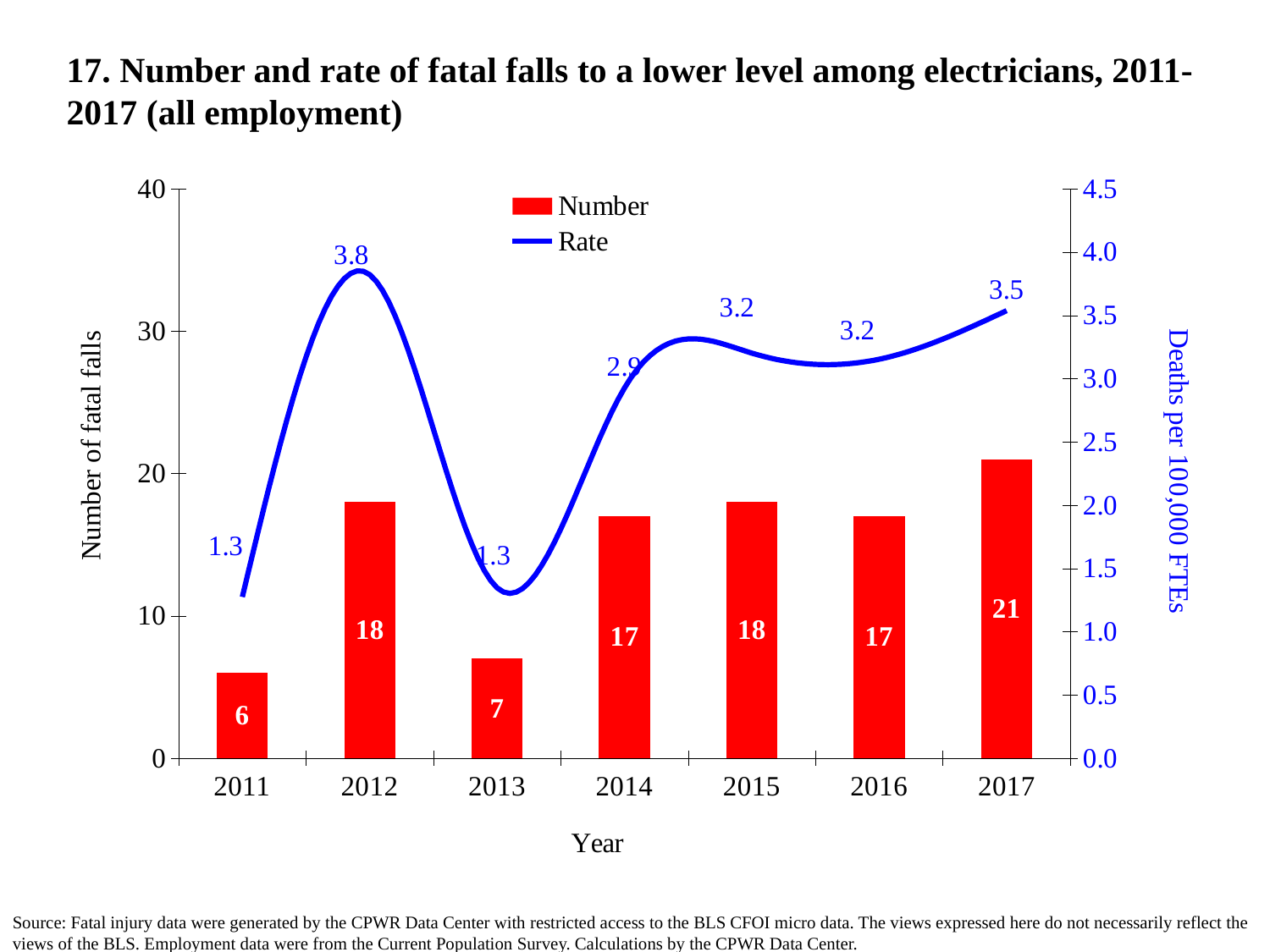
How many years are shown on the x axis? 7 How many series does the legend list? 2 Which is larger, the number of fatal falls in 2012 or in 2014? 2012 What is the number of fatal falls in 2011? 6 What kind of chart is used to show the Number series? bar chart What is the difference between the number of fatal falls in 2017 and in 2013? 14 What is the label of the right-hand vertical axis? Deaths per 100,000 FTEs Which year has the lowest number of fatal falls? 2011 What is the number of fatal falls in 2017? 21 Which year has the highest number of fatal falls? 2017 Which year has the highest rate of fatal falls? 2012 What is the rate of fatal falls (deaths per 100,000 FTEs) in 2012? 3.8